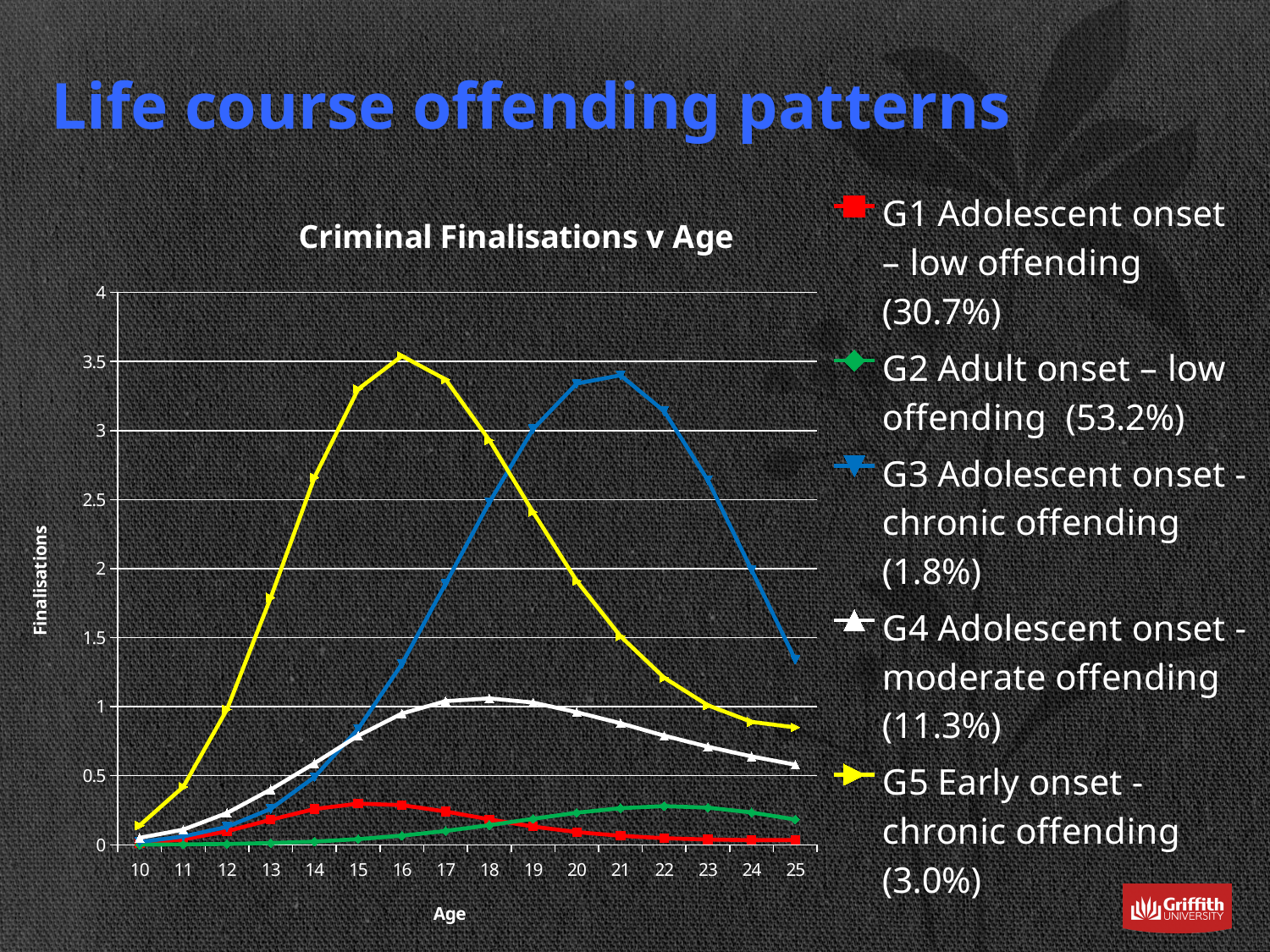
What is the title of the chart? Criminal Finalisations v Age How many series does the legend list? 5 What percentage is shown in the legend for G2 Adult onset – low offending? 53.2% At age 16, which series has the higher value: G5 Early onset - chronic offending or G3 Adolescent onset - chronic offending? G5 Early onset - chronic offending How many age points are plotted along the x axis? 16 Do the values for G3 Adolescent onset - chronic offending rise or fall from age 21 to age 25? fall At age 22, which series has the higher value: G3 Adolescent onset - chronic offending or G5 Early onset - chronic offending? G3 Adolescent onset - chronic offending Is the value for G4 Adolescent onset - moderate offending at age 18 greater or less than 1.5? less What kind of chart is shown on the slide? line chart Is the value for G3 Adolescent onset - chronic offending at age 21 greater or less than 3? greater Is the value for G5 Early onset - chronic offending at age 16 greater or less than 3? greater